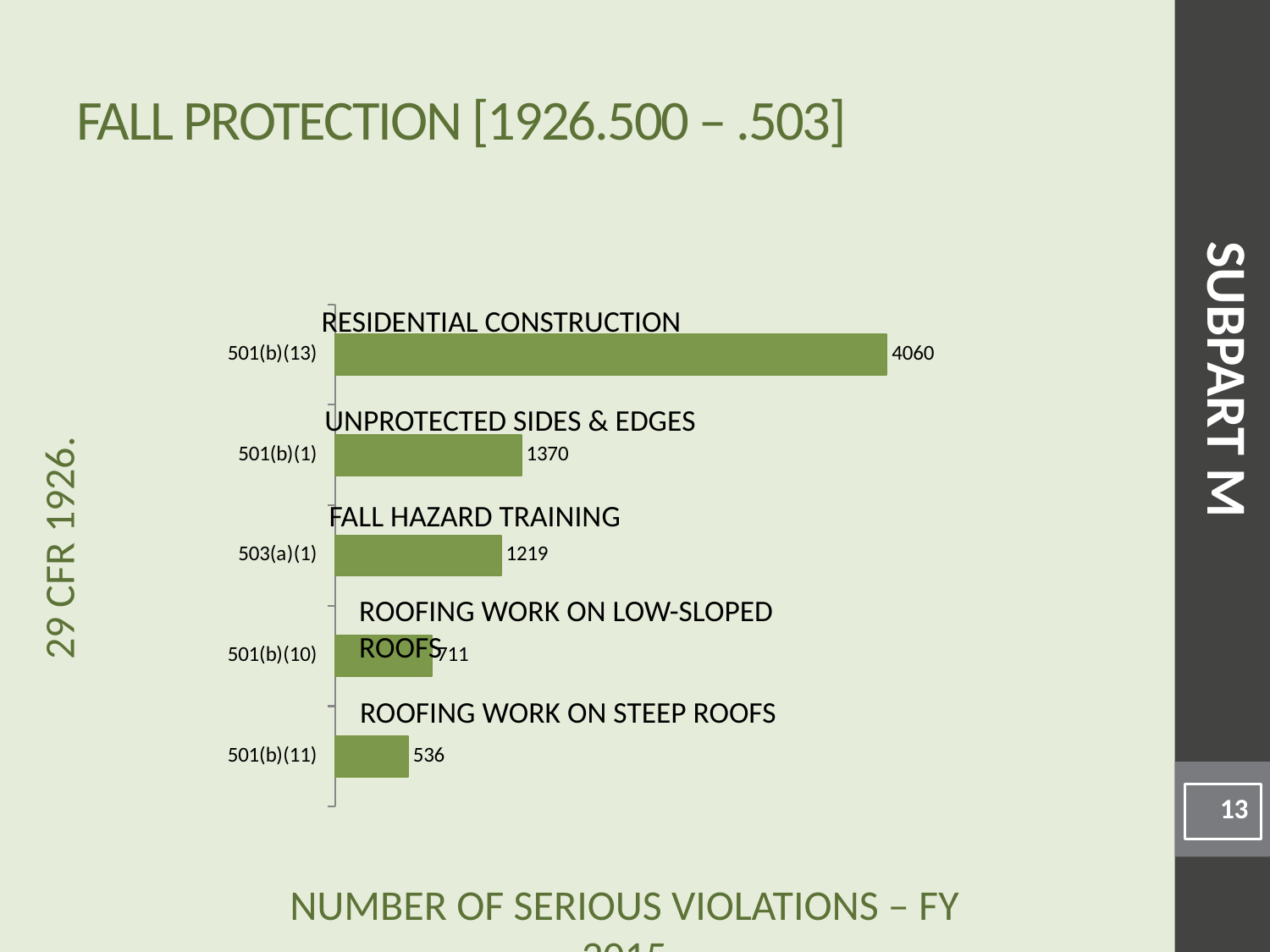
Which standard has the highest number of serious violations? 501(b)(13) Which has more serious violations, 503(a)(1) or 501(b)(11)? 503(a)(1) What is the number of serious violations for 501(b)(1) (Unprotected Sides & Edges)? 1370 What is the number of serious violations for 503(a)(1) (Fall Hazard Training)? 1219 What is the number of serious violations for 501(b)(11) (Roofing Work on Steep Roofs)? 536 How many standards (bars) are shown in the chart? 5 What is the difference in serious violations between 501(b)(13) and 501(b)(1)? 2690 What is the difference in serious violations between 501(b)(1) and 503(a)(1)? 151 What is the number of serious violations for 501(b)(13) (Residential Construction)? 4060 What is the title of the slide? FALL PROTECTION [1926.500 – .503] Which standard has the lowest number of serious violations? 501(b)(11) What type of chart is shown on the slide? bar chart